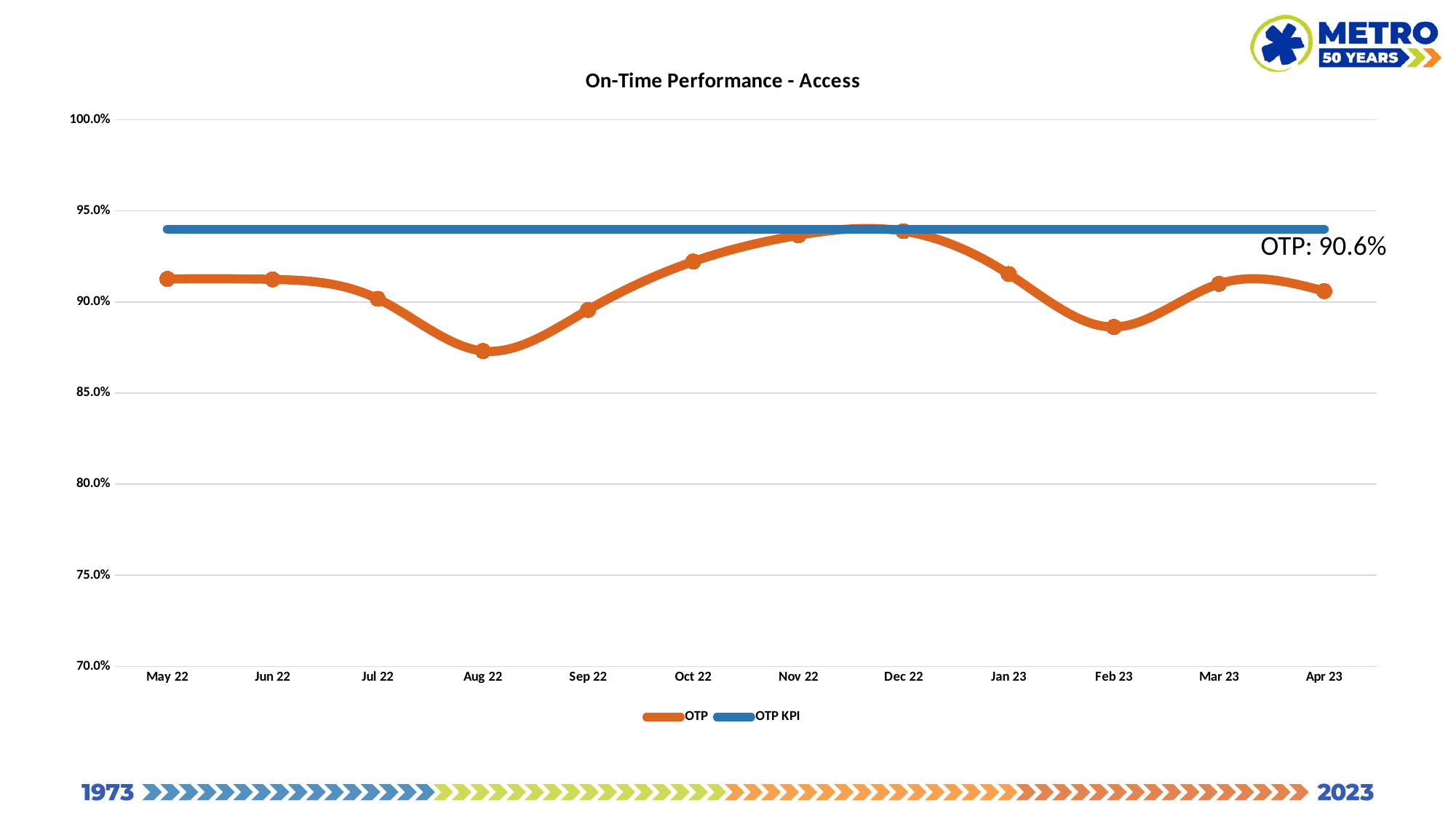
Is the OTP value for Aug 22 greater or less than 90.0%? less Which month has the lowest OTP value? Aug 22 How many series does the legend list? 2 How many months are shown on the x axis? 12 Which is larger, the OTP value for Aug 22 or for Oct 22? Oct 22 What are the two entries in the legend? OTP and OTP KPI What kind of chart is shown on the slide? line chart What is the OTP value for Apr 23? 90.6% Is the OTP value for Feb 23 greater or less than 90.0%? less What is the title of the chart? On-Time Performance - Access Is the OTP value for Oct 22 greater or less than 90.0%? greater Does the OTP line rise or fall from Aug 22 to Nov 22? rise